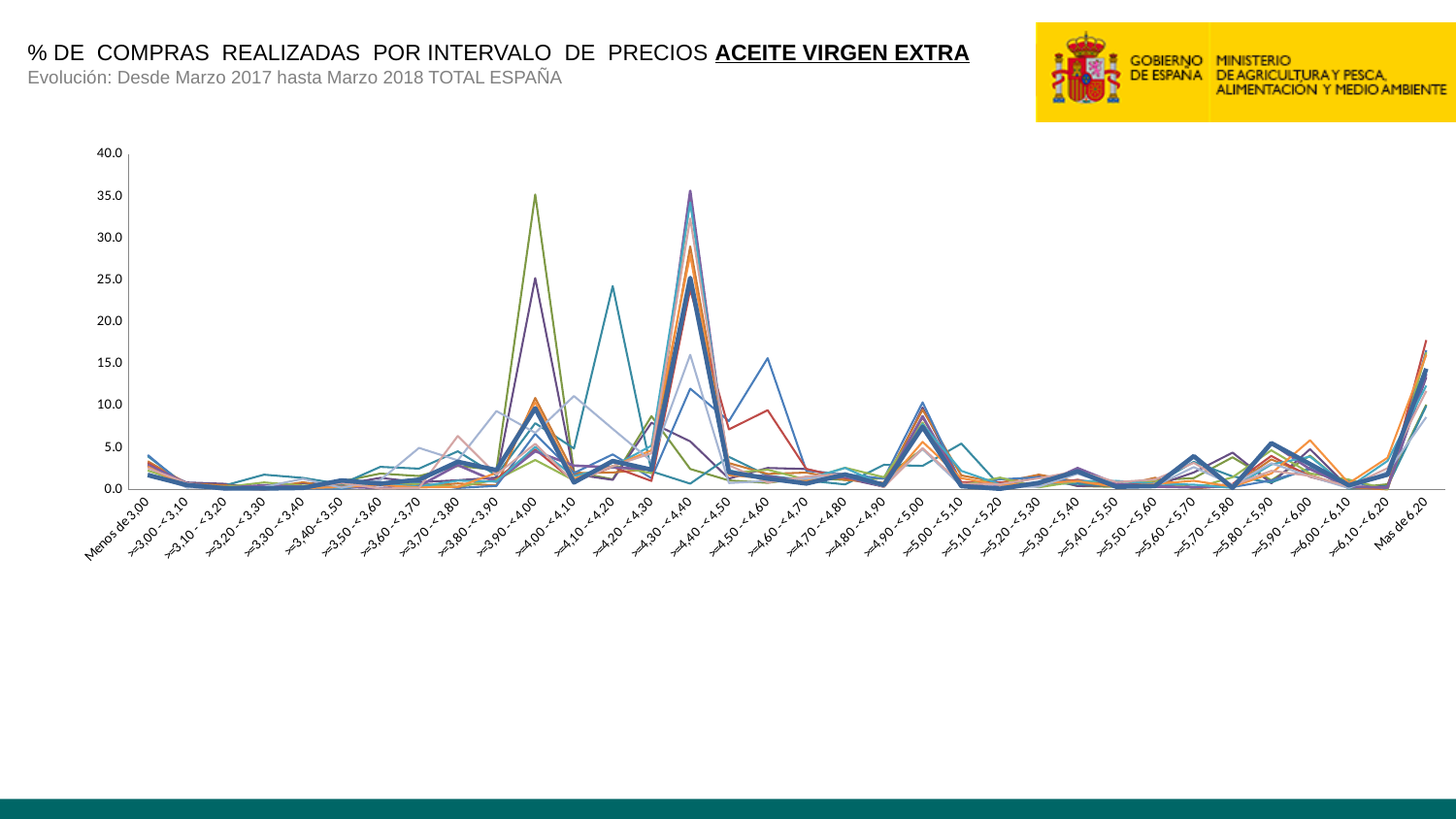
Is the highest value plotted at the interval >=3,90 - <4,00 greater or less than 30.0? greater Is the highest value plotted at the interval >=5,00 - <5,10 greater or less than 15.0? less What period does the subtitle say the chart covers? Desde Marzo 2017 hasta Marzo 2018 How many price-interval categories are shown along the x axis? 34 Is the highest value plotted at the category 'Mas de 6,20' greater or less than 10.0? greater At which price interval does the highest peak of any line occur? >=4,30 - <4,40 What is the maximum value shown on the y axis? 40.0 What kind of chart is shown on the slide? Line chart